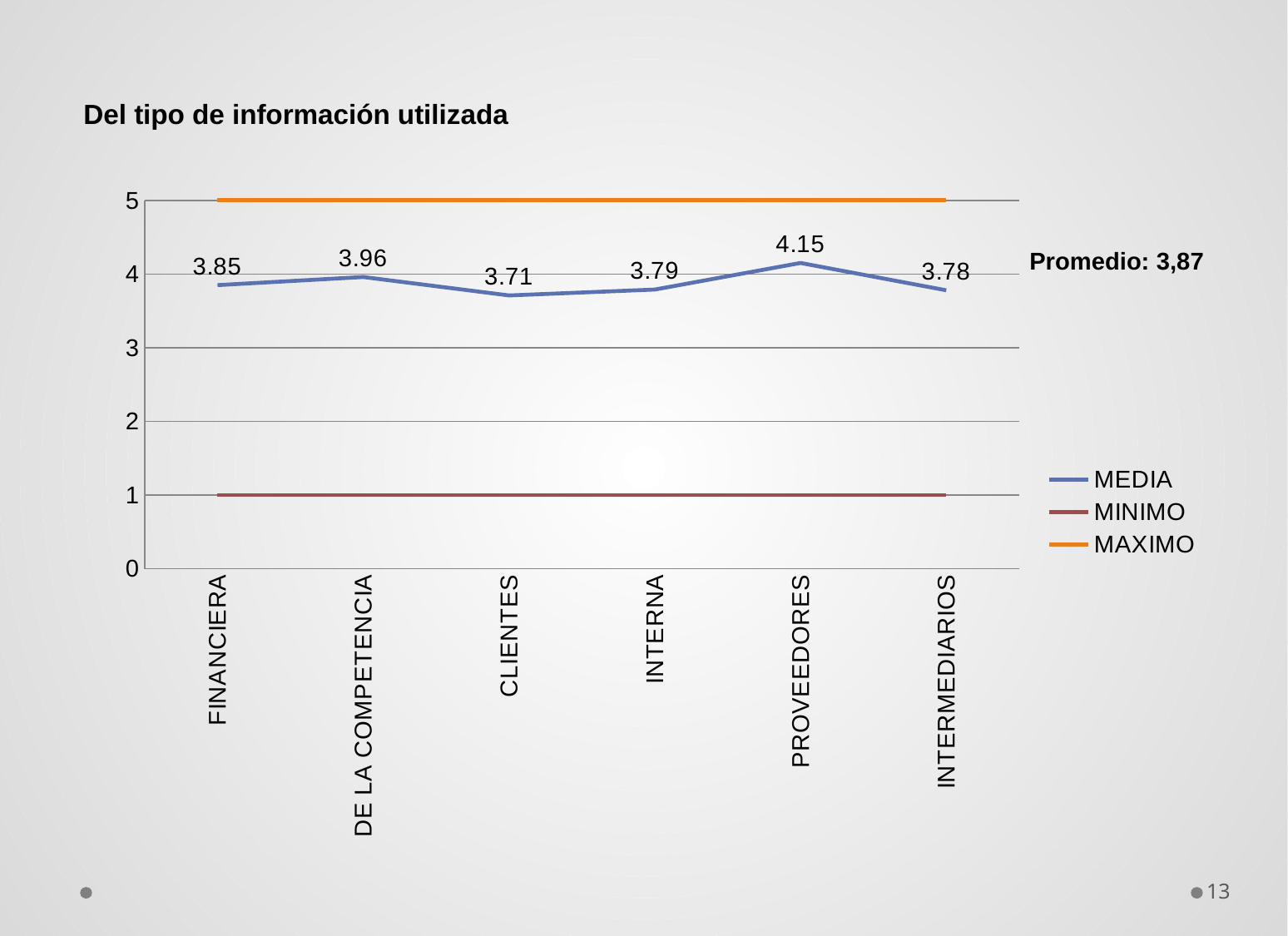
How many categories are shown on the x axis? 6 What is the MEDIA value for DE LA COMPETENCIA? 3.96 Which has a larger MEDIA value, FINANCIERA or INTERNA? FINANCIERA Which category has the highest MEDIA value? PROVEEDORES What is the MEDIA value for PROVEEDORES? 4.15 At what value does the MAXIMO line sit across all categories? 5 What is the MEDIA value for CLIENTES? 3.71 How many series does the legend list? 3 What is the Promedio value stated next to the chart? 3,87 What is the difference between the MEDIA values for PROVEEDORES and CLIENTES? 0.44 What kind of chart is shown on the slide? Line chart Which category has the lowest MEDIA value? CLIENTES